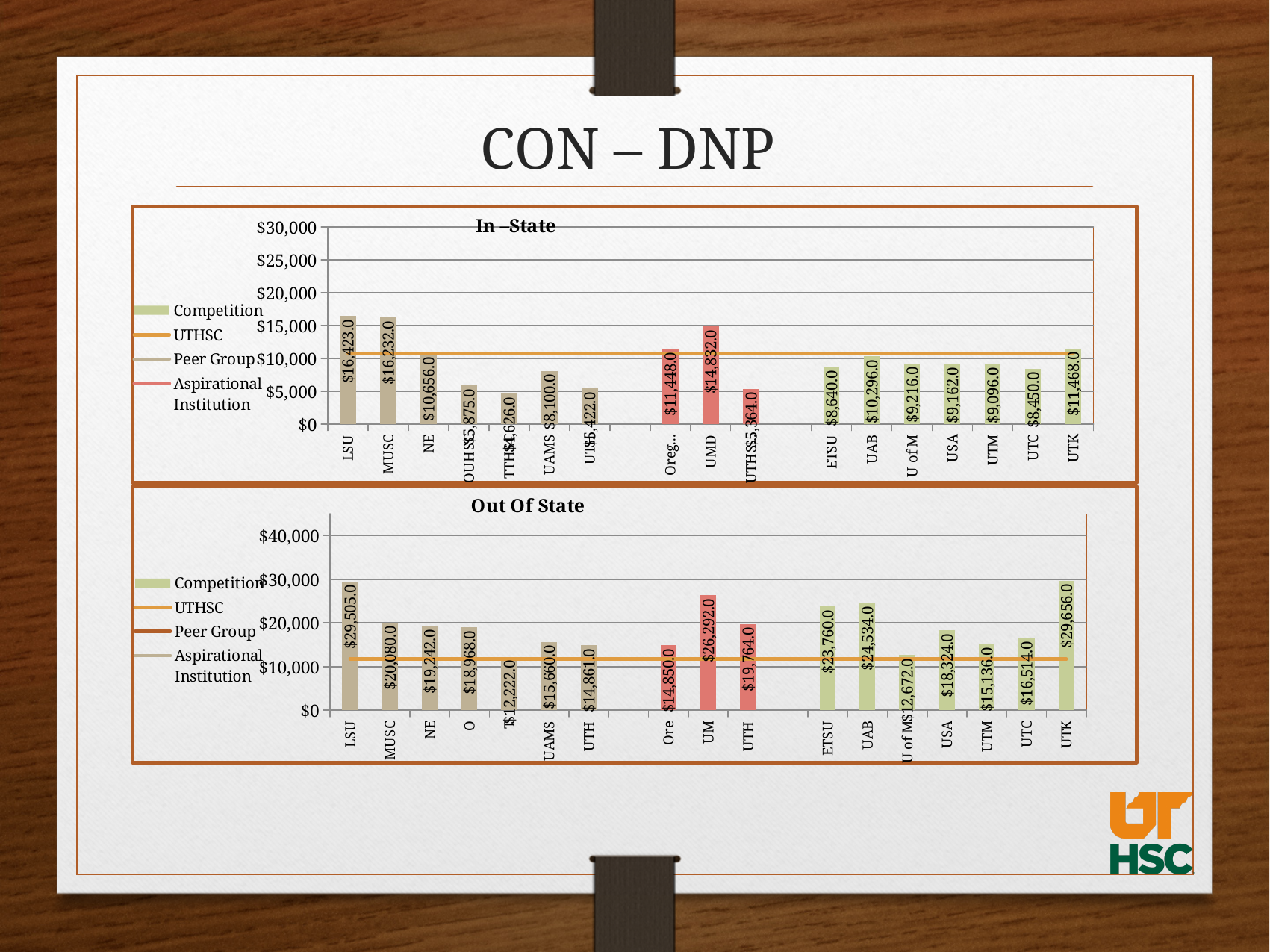
On the Out Of State chart, is the value for LSU greater or less than $20,000? greater On the Out Of State chart, what is the value for ETSU? $23,760.0 On the Out Of State chart, what is the value for UM? $26,292.0 On the In –State chart, which category has the lowest value? TTHSC How many bars are plotted on the Out Of State chart? 17 On the In –State chart, what is the value for UMD? $14,832.0 On the Out Of State chart, what is the difference between the values for UAB and USA? $6,210.0 What kind of chart is the Out Of State chart? Bar chart On the In –State chart, what is the value for UAB? $10,296.0 On the In –State chart, which is larger, the value for UTK or the value for ETSU? UTK On the In –State chart, which category has the highest value? LSU How many entries does the legend of the In –State chart list? 4